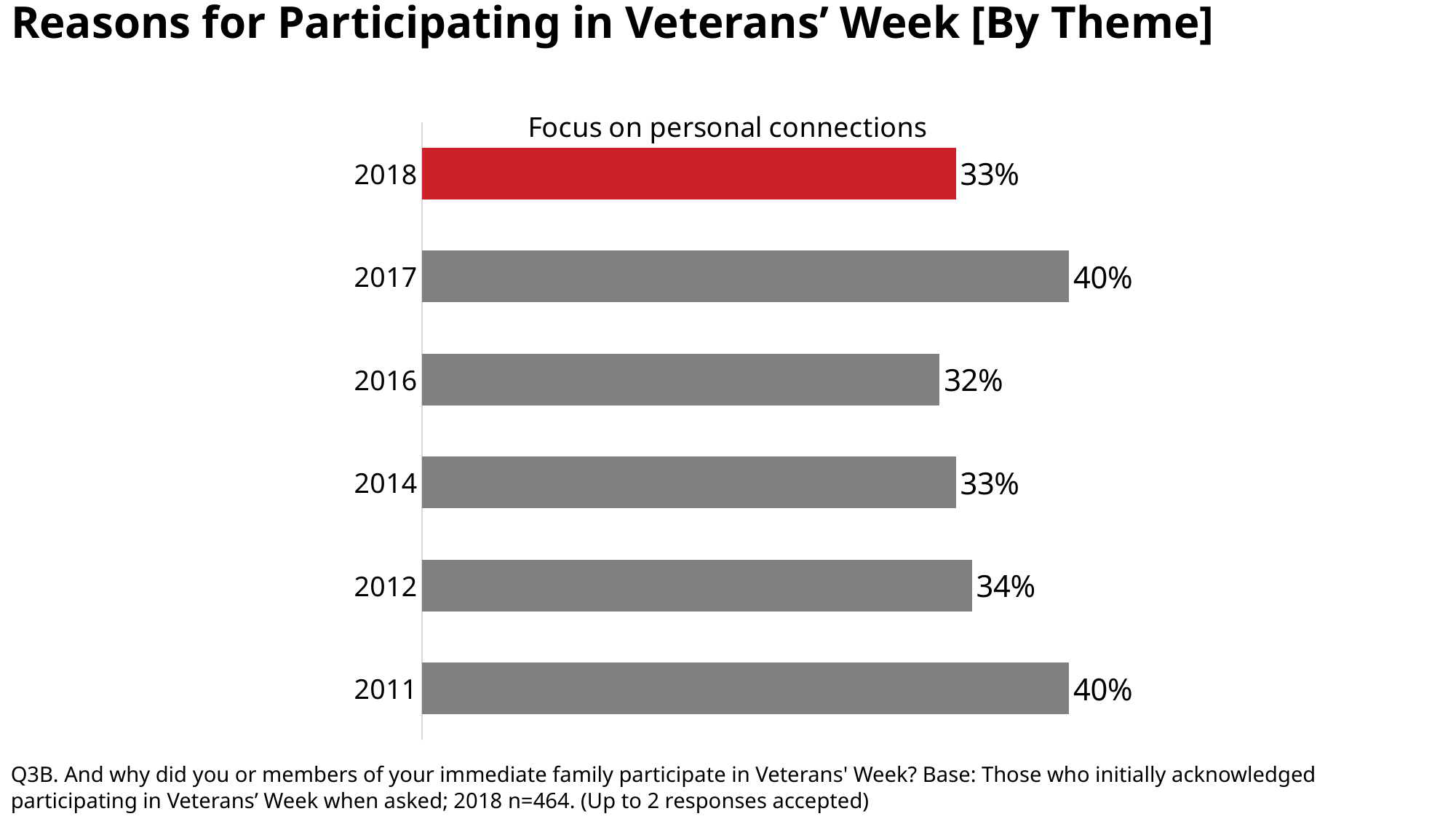
What is the value for 2016? 32% What is the value for 2012? 34% Which year's bar is coloured red? 2018 Which year has the lowest value? 2016 What is the difference between the values for 2017 and 2018? 7% What is the difference between the values for 2012 and 2016? 2% What is the title of the chart? Focus on personal connections What is the value for 2018? 33% What kind of chart is shown? Bar chart Which is larger, the value for 2017 or the value for 2016? 2017 What is the value for 2017? 40% How many years are shown in the chart? 6